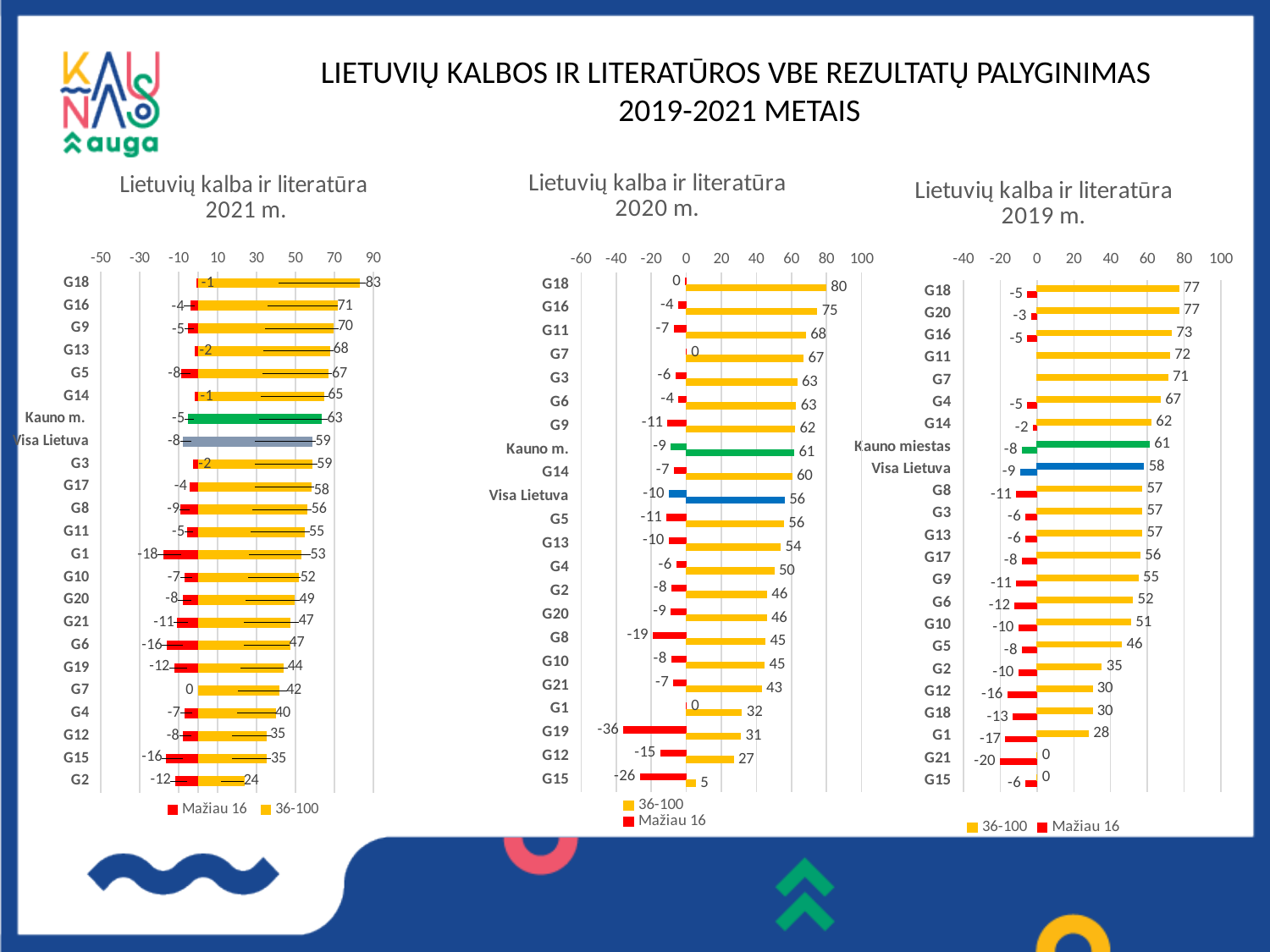
What type of chart is the 'Lietuvių kalba ir literatūra 2021 m.' chart? Bar chart In the 'Lietuvių kalba ir literatūra 2019 m.' chart, what is the 36-100 value for Visa Lietuva? 58 In the 'Lietuvių kalba ir literatūra 2021 m.' chart, which category has the lowest 36-100 value? G2 In the 'Lietuvių kalba ir literatūra 2020 m.' chart, which category has the highest 36-100 value? G18 In the 'Lietuvių kalba ir literatūra 2019 m.' chart, what is the Mažiau 16 value for G21? -20 In the 'Lietuvių kalba ir literatūra 2020 m.' chart, which has a larger 36-100 value, G16 or G11? G16 In the 'Lietuvių kalba ir literatūra 2021 m.' chart, what is the difference between the 36-100 values for Kauno m. and Visa Lietuva? 4 In the 'Lietuvių kalba ir literatūra 2020 m.' chart, which category has the lowest Mažiau 16 value? G19 In the 'Lietuvių kalba ir literatūra 2020 m.' chart, what is the 36-100 value for Kauno m.? 61 In the 'Lietuvių kalba ir literatūra 2021 m.' chart, what is the Mažiau 16 value for G1? -18 In the 'Lietuvių kalba ir literatūra 2021 m.' chart, what is the 36-100 value for G18? 83 How many series does the legend of the 'Lietuvių kalba ir literatūra 2019 m.' chart list? 2